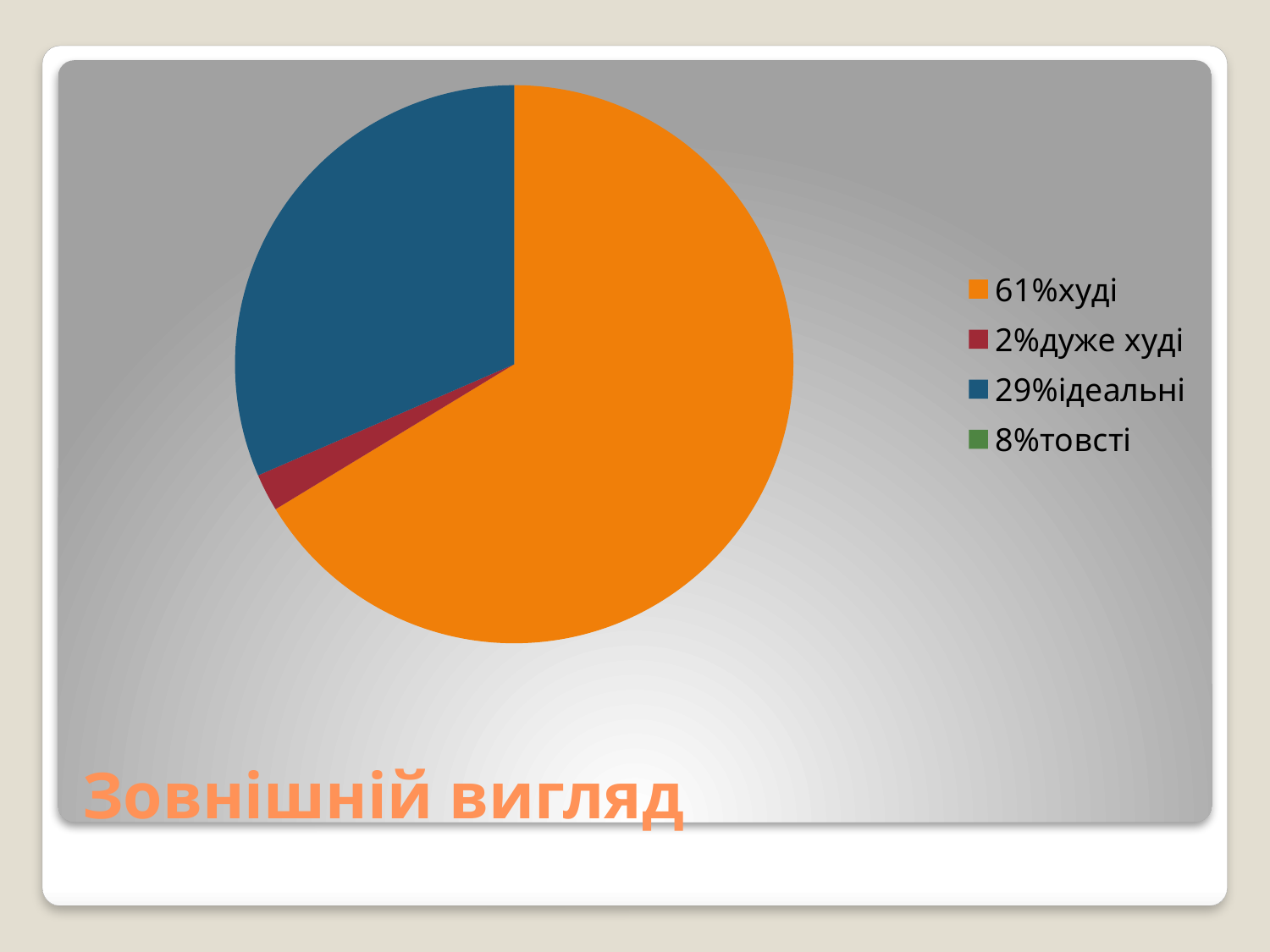
Which category has the largest slice of the pie? худі Which category has the smallest percentage in the legend? дуже худі According to the legend, what percentage is given for "ідеальні"? 29% What colour is the slice for "худі" in the pie chart? orange How many entries does the legend of the pie chart list? 4 Which is larger, the share for "худі" or the share for "ідеальні"? худі According to the legend, what percentage is given for "товсті"? 8% According to the legend, what percentage is given for "дуже худі"? 2% What is the title of the slide with the pie chart? Зовнішній вигляд What is the difference between the percentages for "худі" and "ідеальні"? 32% What kind of chart is shown on the slide? pie chart According to the legend, what percentage is given for "худі"? 61%